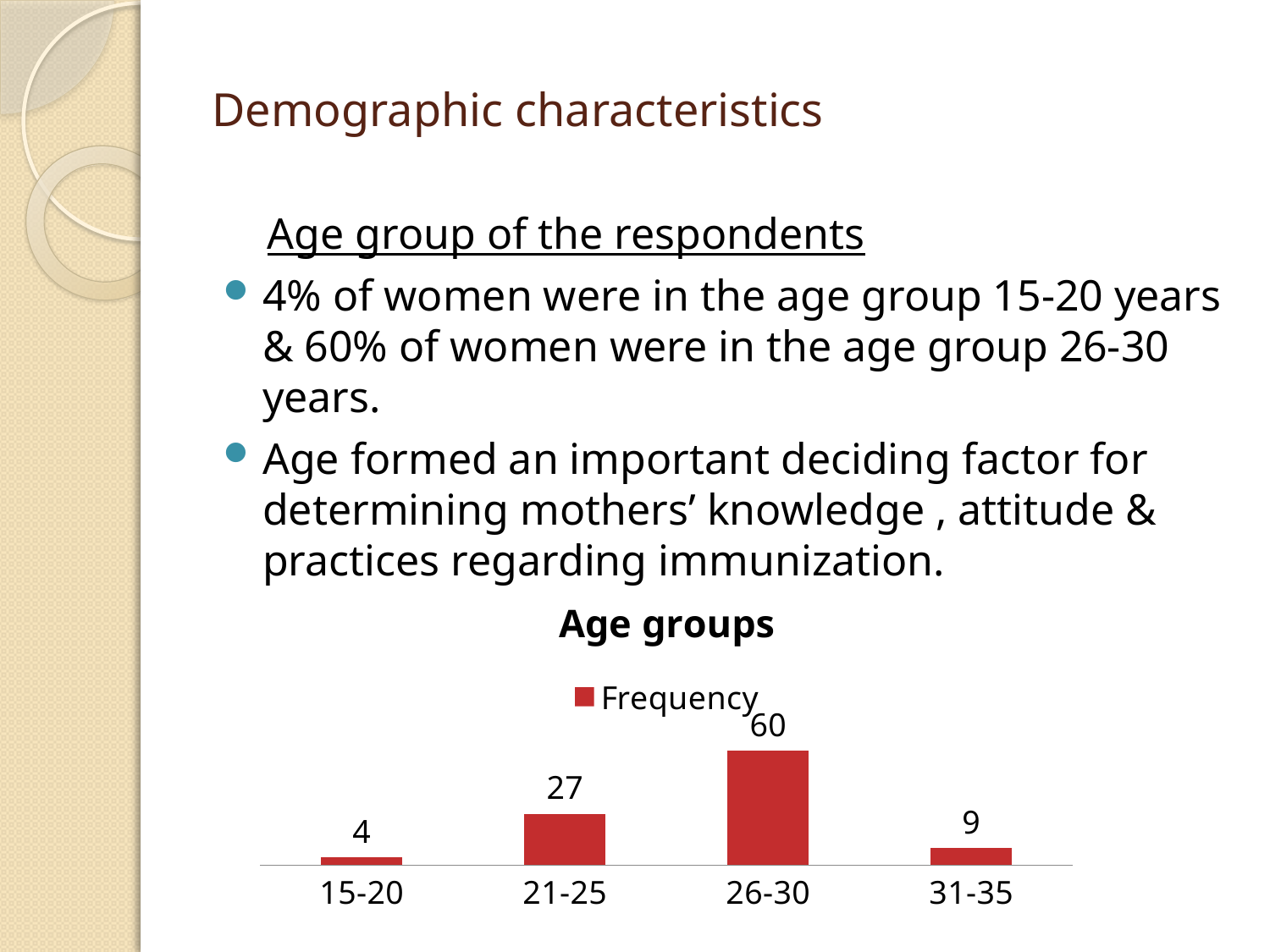
What kind of chart is shown on the slide? Bar chart What is the Frequency value for the 21-25 age group? 27 Which age group has a larger Frequency, 21-25 or 31-35? 21-25 What is the difference in Frequency between the 26-30 and 21-25 age groups? 33 Which age group has the lowest Frequency? 15-20 What is the title of the chart? Age groups What is the Frequency value for the 31-35 age group? 9 What is the Frequency value for the 26-30 age group? 60 What is the Frequency value for the 15-20 age group? 4 How many series does the chart legend list? 1 Which age group has the highest Frequency? 26-30 How many age groups are shown on the x axis of the chart? 4